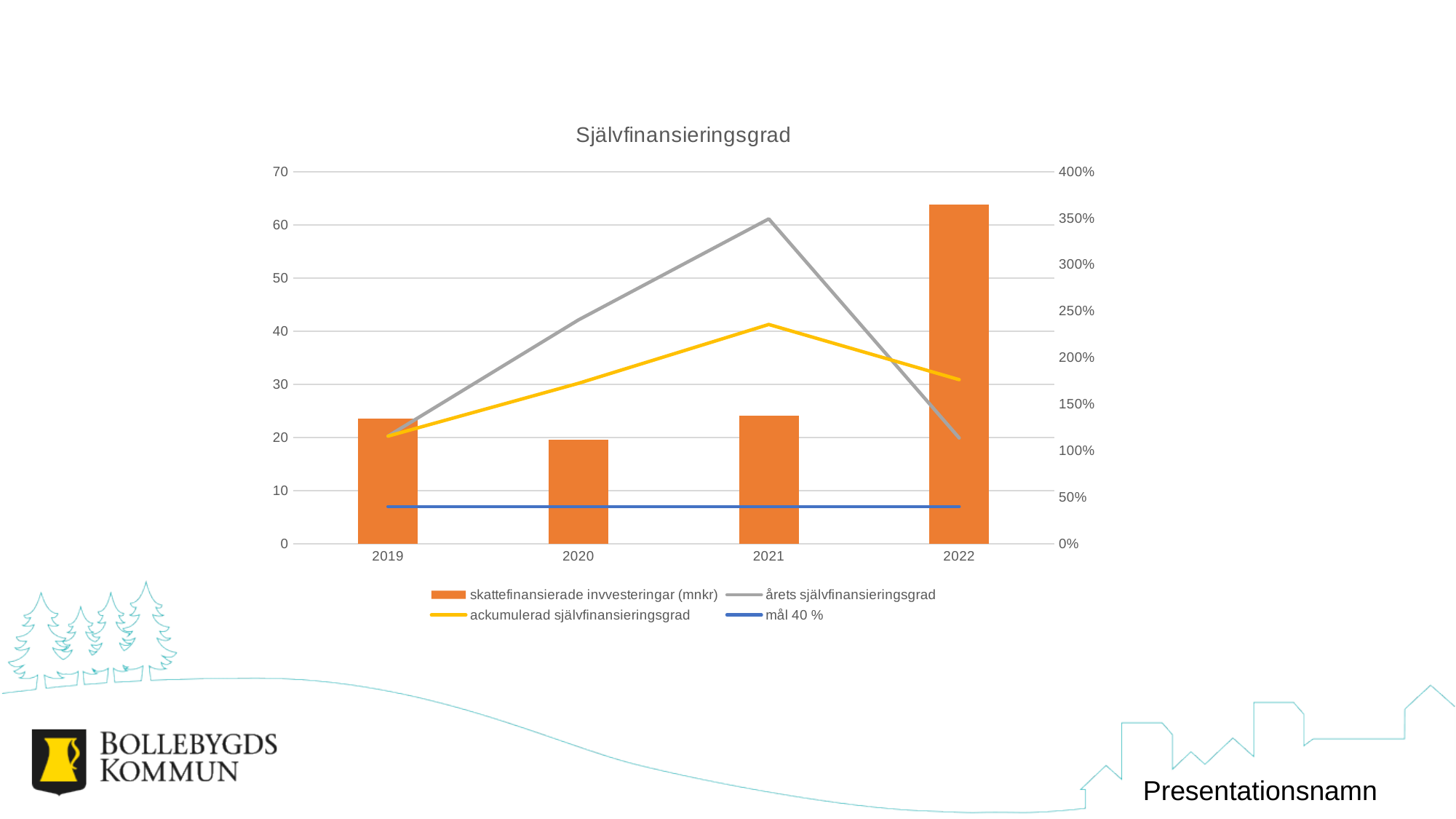
Which year has the highest bar for skattefinansierade invvesteringar (mnkr)? 2022 Is the value of årets självfinansieringsgrad in 2021 greater or less than 300%? greater What is the title of the chart? Självfinansieringsgrad Does årets självfinansieringsgrad rise or fall from 2021 to 2022? fall Which series is drawn as a flat blue line? mål 40 % Which is larger, the bar for skattefinansierade invvesteringar (mnkr) in 2022 or in 2019? 2022 How many series does the legend list? 4 Is the bar for skattefinansierade invvesteringar (mnkr) in 2022 greater or less than 60? greater Is the value of ackumulerad självfinansieringsgrad in 2019 greater or less than 150%? less How many years are shown on the x axis? 4 Which year has the lowest bar for skattefinansierade invvesteringar (mnkr)? 2020